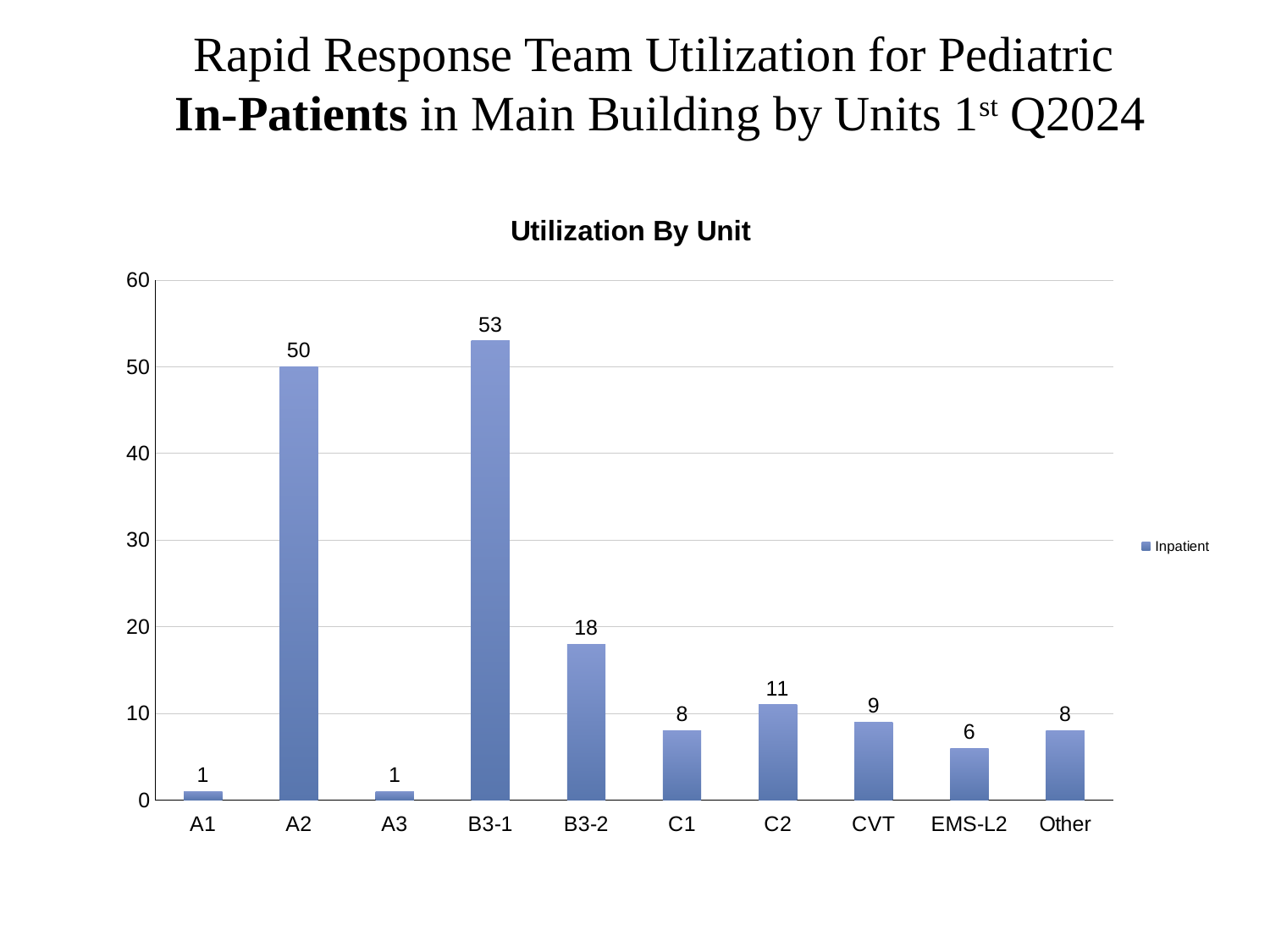
What is the difference between the values for B3-1 and A2? 3 What is the title of the chart? Utilization By Unit Which is larger, the value for CVT or the value for EMS-L2? CVT What is the value for C2? 11 What is the value for B3-1? 53 What is the value for EMS-L2? 6 Which units have the lowest value? A1 and A3 How many units are shown on the x axis? 10 What is the difference between the values for B3-2 and C1? 10 Which unit has the highest value? B3-1 Is the value for A2 greater or less than 40? greater What kind of chart is this? Bar chart